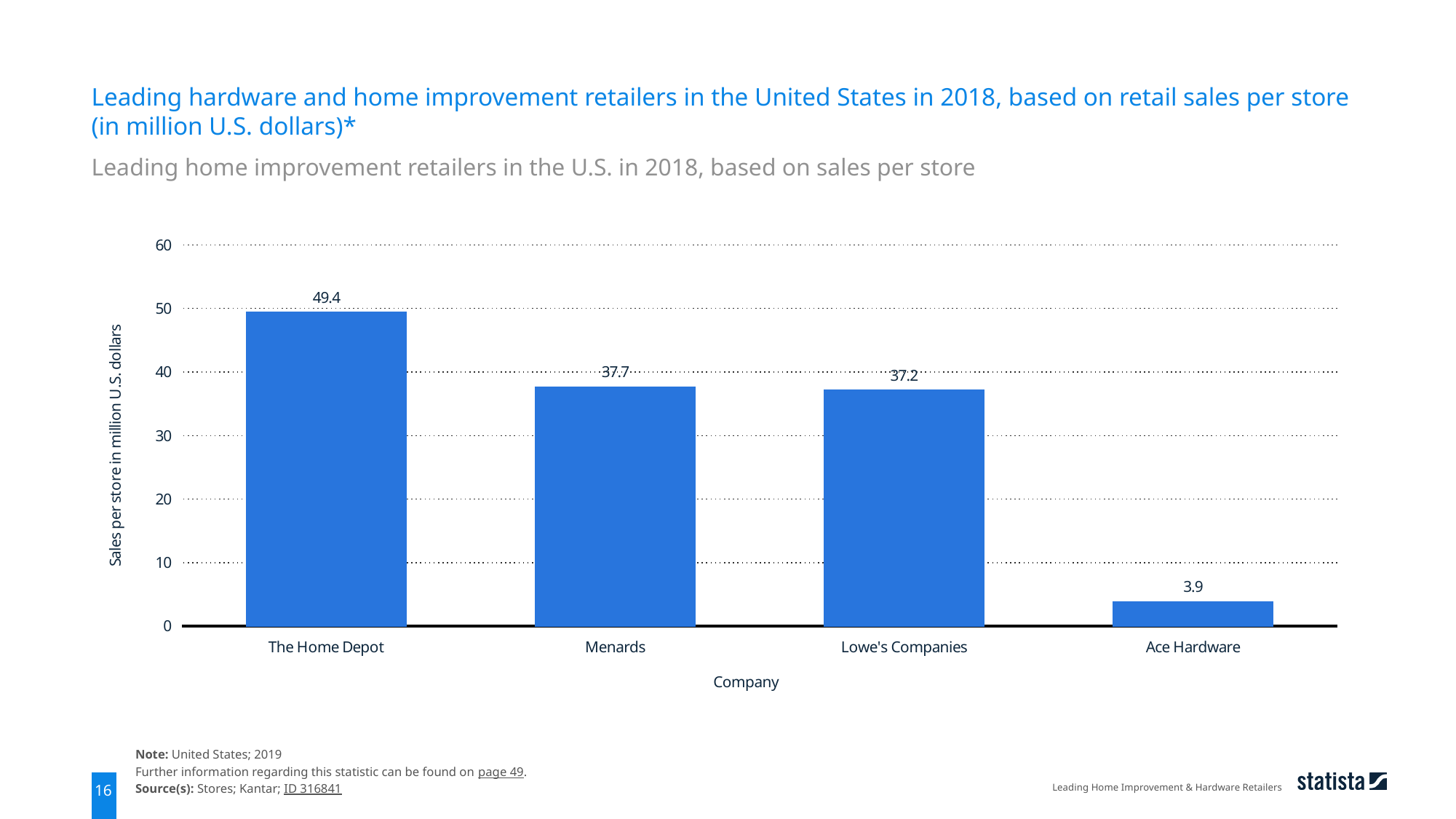
How many companies are shown in the chart? 4 What is the sales per store value for Menards? 37.7 Which company has the highest sales per store? The Home Depot Is the value for Lowe's Companies greater or less than 40? less What is the sales per store value for The Home Depot? 49.4 Which company has the lowest sales per store? Ace Hardware What is the sales per store value for Ace Hardware? 3.9 What is the difference in sales per store between The Home Depot and Lowe's Companies? 12.2 Which has higher sales per store, The Home Depot or Menards? The Home Depot What is the label of the y axis? Sales per store in million U.S. dollars What is the label of the x axis? Company What kind of chart is shown on the slide? bar chart